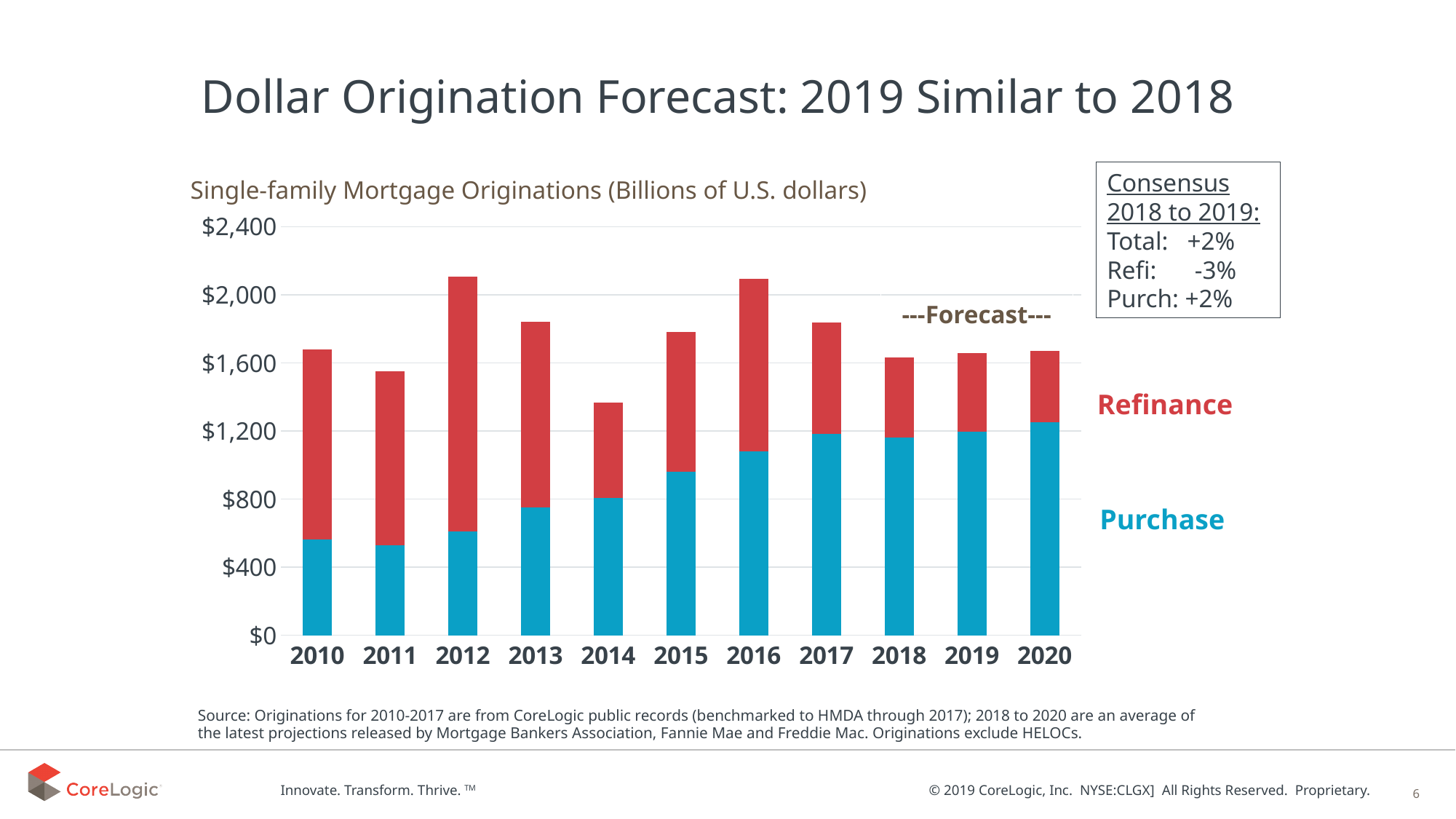
Is the total originations value for 2014 greater or less than $1,600? less How many series does the chart show? 2 Is the Purchase value for 2020 greater or less than $1,200? greater Which is larger, the total originations in 2016 or in 2018? 2016 Which year has the lowest total single-family mortgage originations? 2014 Which series is shown in red in the chart? Refinance Is the total originations value for 2012 greater or less than $2,000? greater Which year has the highest Purchase originations? 2020 Do Purchase originations generally rise or fall from 2010 to 2020? rise What kind of chart is shown on the slide? Stacked bar chart How many years are shown on the x axis of the chart? 11